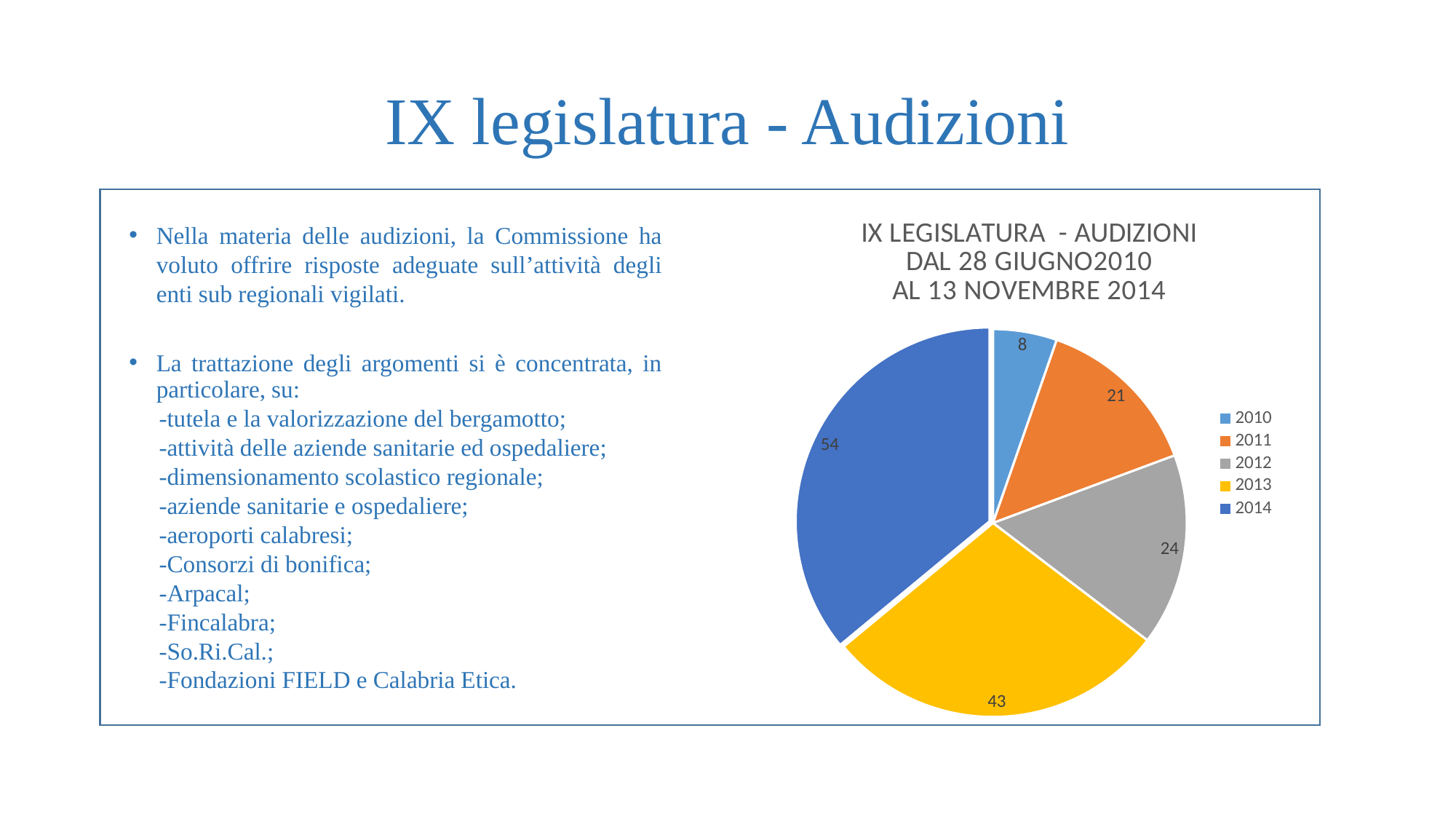
What type of chart is shown on the slide? Pie chart What is the value for 2013 in the pie chart? 43 What is the difference between the values for 2014 and 2013? 11 How many slices does the pie chart have? 5 What is the value for 2012 in the pie chart? 24 What is the value for 2010 in the pie chart? 8 Which is larger, the value for 2011 or the value for 2012? 2012 Which year has the smallest slice in the pie chart? 2010 How many entries does the legend list? 5 Which year has the largest slice in the pie chart? 2014 What is the total of all the slices in the pie chart? 150 What share of the pie does the 2014 slice represent? 36%